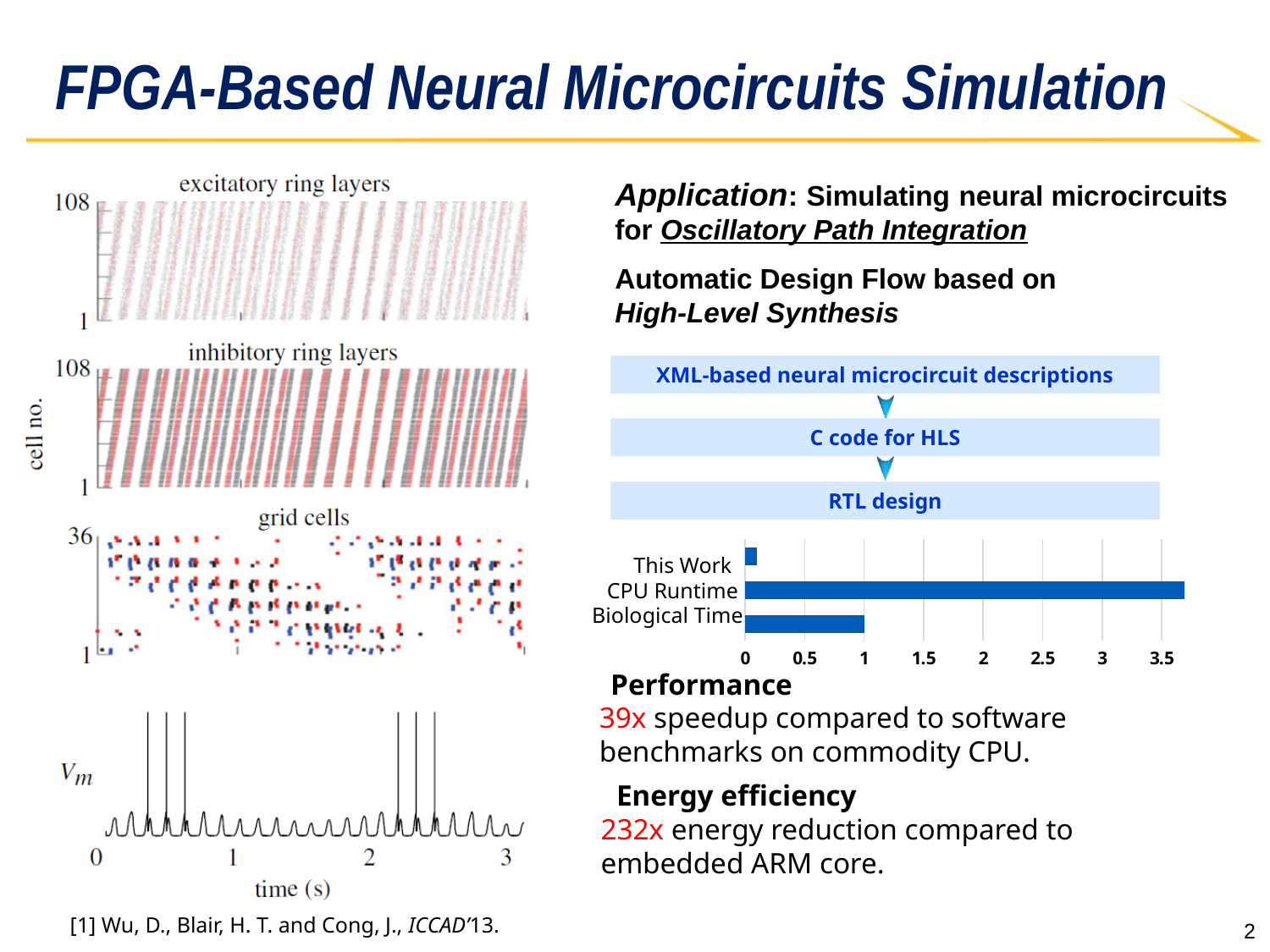
In the bar chart on the right, what is the highest tick label shown on the horizontal axis? 3.5 In the bar chart on the right, which is larger, the value for This Work or the value for Biological Time? Biological Time In the bar chart on the right, which category has the shortest bar? This Work In the bar chart on the right, which is larger, the value for CPU Runtime or the value for Biological Time? CPU Runtime What kind of chart is the chart on the right of the slide with the categories This Work, CPU Runtime and Biological Time? bar chart In the bar chart on the right, which category has the longest bar? CPU Runtime In the bar chart on the right, what value does the Biological Time bar reach on the axis? 1 In the bar chart on the right, is the value for This Work greater or less than 0.5? less In the bar chart on the right, is the value for CPU Runtime greater or less than 3? greater In the bar chart on the right, how many categories are plotted? 3 In the bar chart on the right, is the value for Biological Time greater or less than 1.5? less In the bar chart on the right, what colour are the bars? blue